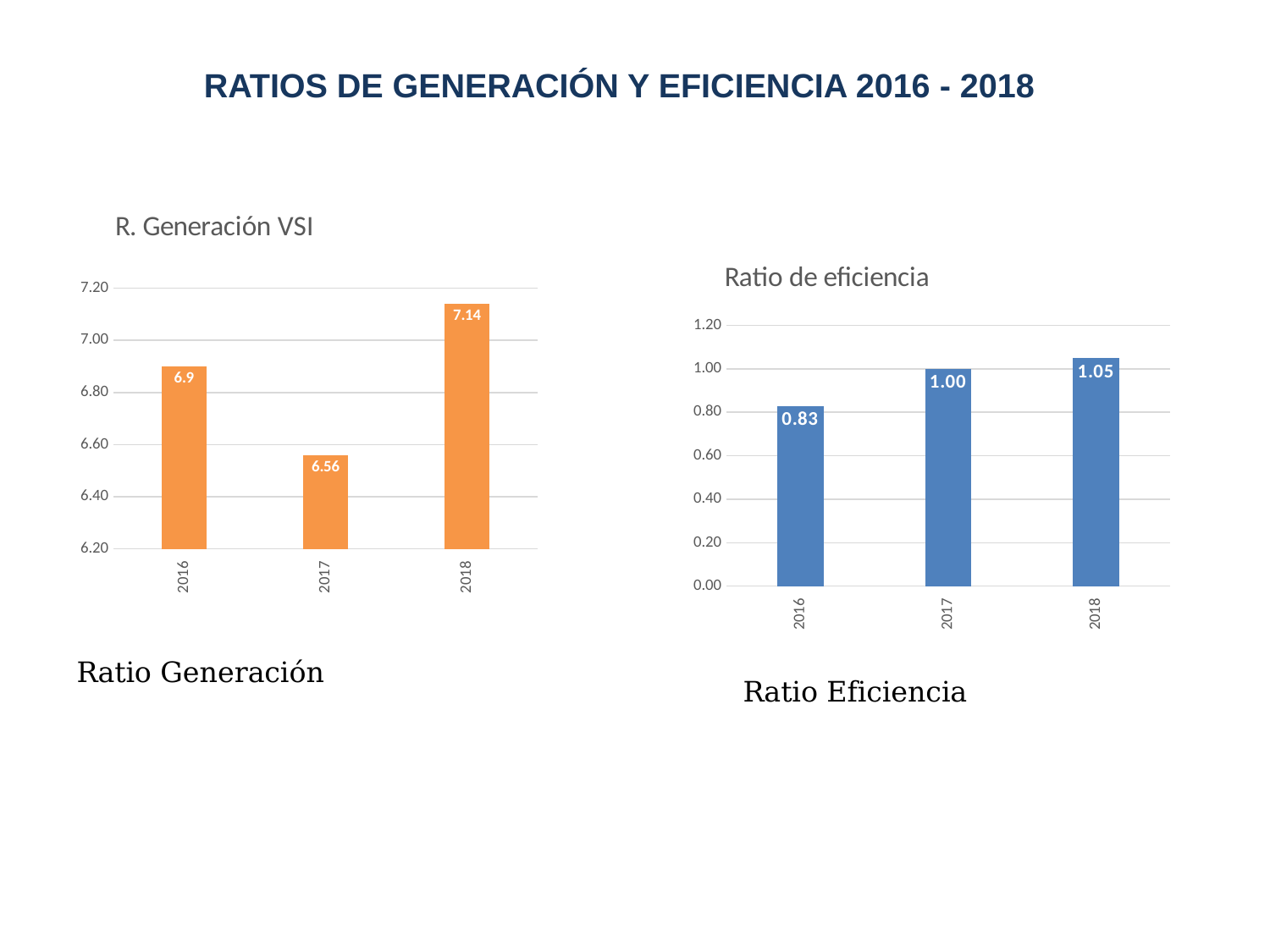
In the 'R. Generación VSI' chart, what is the difference between the 2018 and 2017 values? 0.58 In the 'Ratio de eficiencia' chart, what is the difference between the 2017 and 2016 values? 0.17 In the 'R. Generación VSI' chart, what is the value for 2018? 7.14 In the 'Ratio de eficiencia' chart, what is the value for 2016? 0.83 What kind of chart is the 'R. Generación VSI' chart? Bar chart How many years are shown in the 'Ratio de eficiencia' chart? 3 In the 'R. Generación VSI' chart, which is larger, the value for 2016 or the value for 2017? 2016 In the 'R. Generación VSI' chart, what is the value for 2017? 6.56 In the 'Ratio de eficiencia' chart, do the values rise or fall from 2016 to 2018? Rise In the 'Ratio de eficiencia' chart, what is the value for 2018? 1.05 In the 'Ratio de eficiencia' chart, which year has the highest value? 2018 In the 'R. Generación VSI' chart, which year has the lowest value? 2017